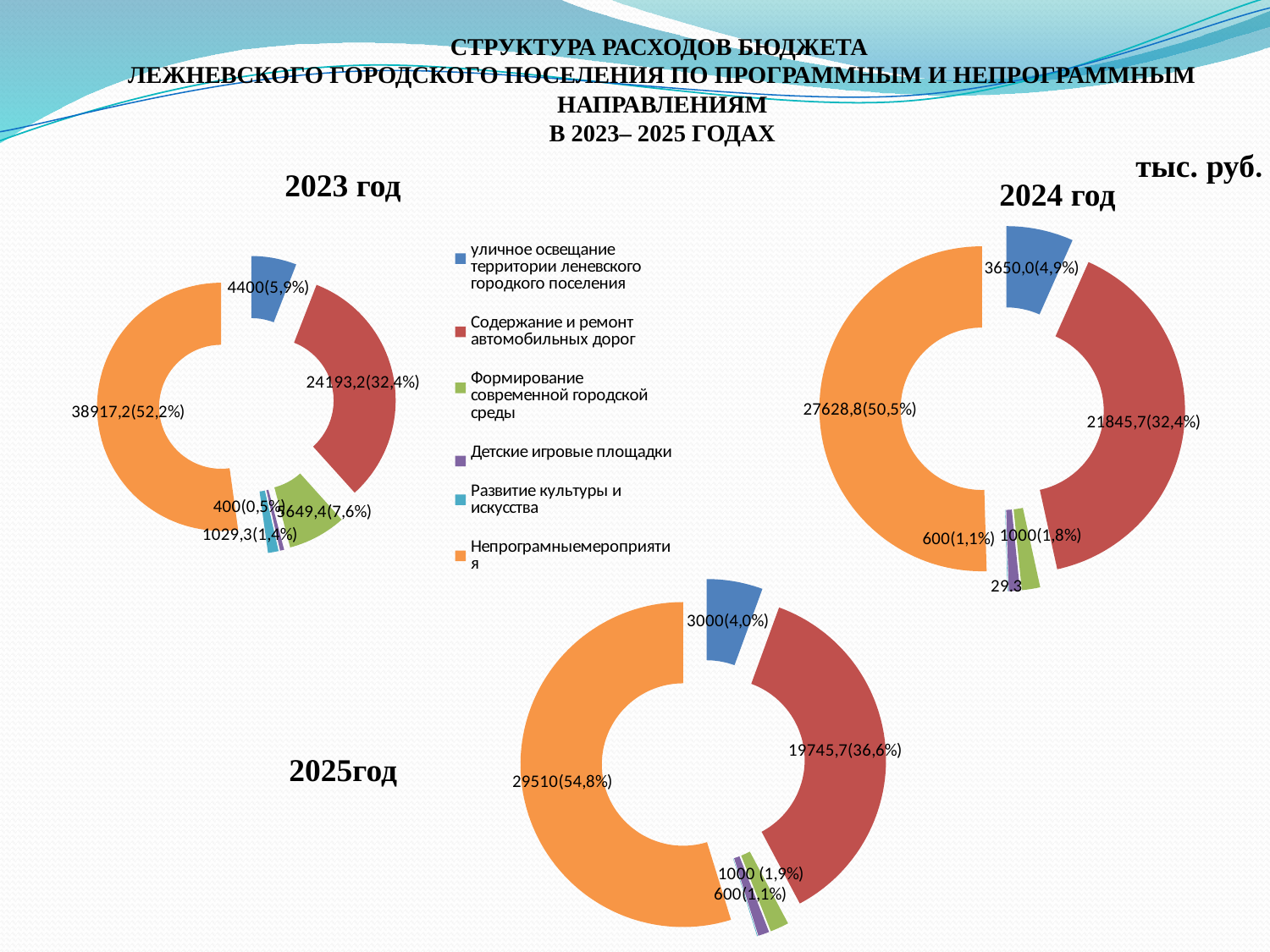
How many entries does the legend list? 6 In the 2024 год chart, what is the value shown for Непрограмные мероприятия? 27628,8(50,5%) In the 2025 год chart, what is the value shown for Содержание и ремонт автомобильных дорог? 19745,7(36,6%) In the 2025 год chart, what is the value shown for уличное освещение территории леневского городкого поселения? 3000(4,0%) In the 2024 год chart, what is the value shown for уличное освещение территории леневского городкого поселения? 3650,0(4,9%) In the 2025 год chart, which category has the largest share? Непрограмные мероприятия In the 2023 год chart, which category has the smallest share? Детские игровые площадки What kind of chart is used for each year on the slide? Doughnut (pie) chart In the 2023 год chart, what is the value shown for Содержание и ремонт автомобильных дорог? 24193,2(32,4%) In the 2023 год chart, what is the value shown for Формирование современной городской среды? 5649,4(7,6%) In the 2024 год chart, which is larger: Содержание и ремонт автомобильных дорог or уличное освещение? Содержание и ремонт автомобильных дорог In the 2023 год chart, what is the value shown for Непрограмные мероприятия? 38917,2(52,2%)